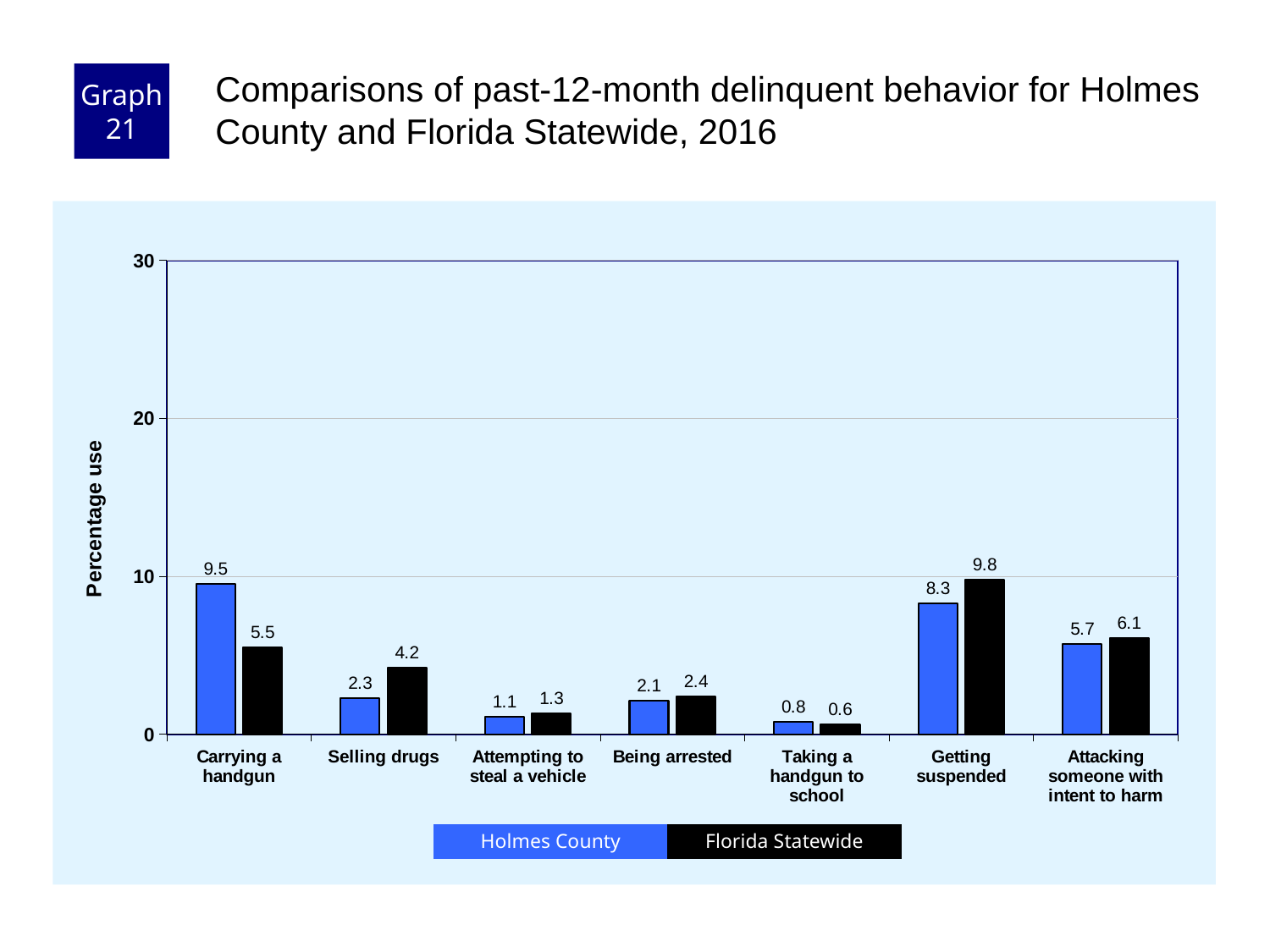
What is the Florida Statewide value for Getting suspended? 9.8 What is the difference between the Holmes County and Florida Statewide values for Carrying a handgun? 4.0 What is the Holmes County value for Carrying a handgun? 9.5 How many series does the legend list? 2 Which category has the highest Holmes County value? Carrying a handgun Which is larger for Getting suspended: Holmes County or Florida Statewide? Florida Statewide What kind of chart is shown on the slide? Bar chart Is the Florida Statewide value for Carrying a handgun greater or less than 10? less Which category has the lowest Florida Statewide value? Taking a handgun to school What is the Holmes County value for Taking a handgun to school? 0.8 What is the difference between the Florida Statewide and Holmes County values for Selling drugs? 1.9 How many categories are shown on the x axis? 7